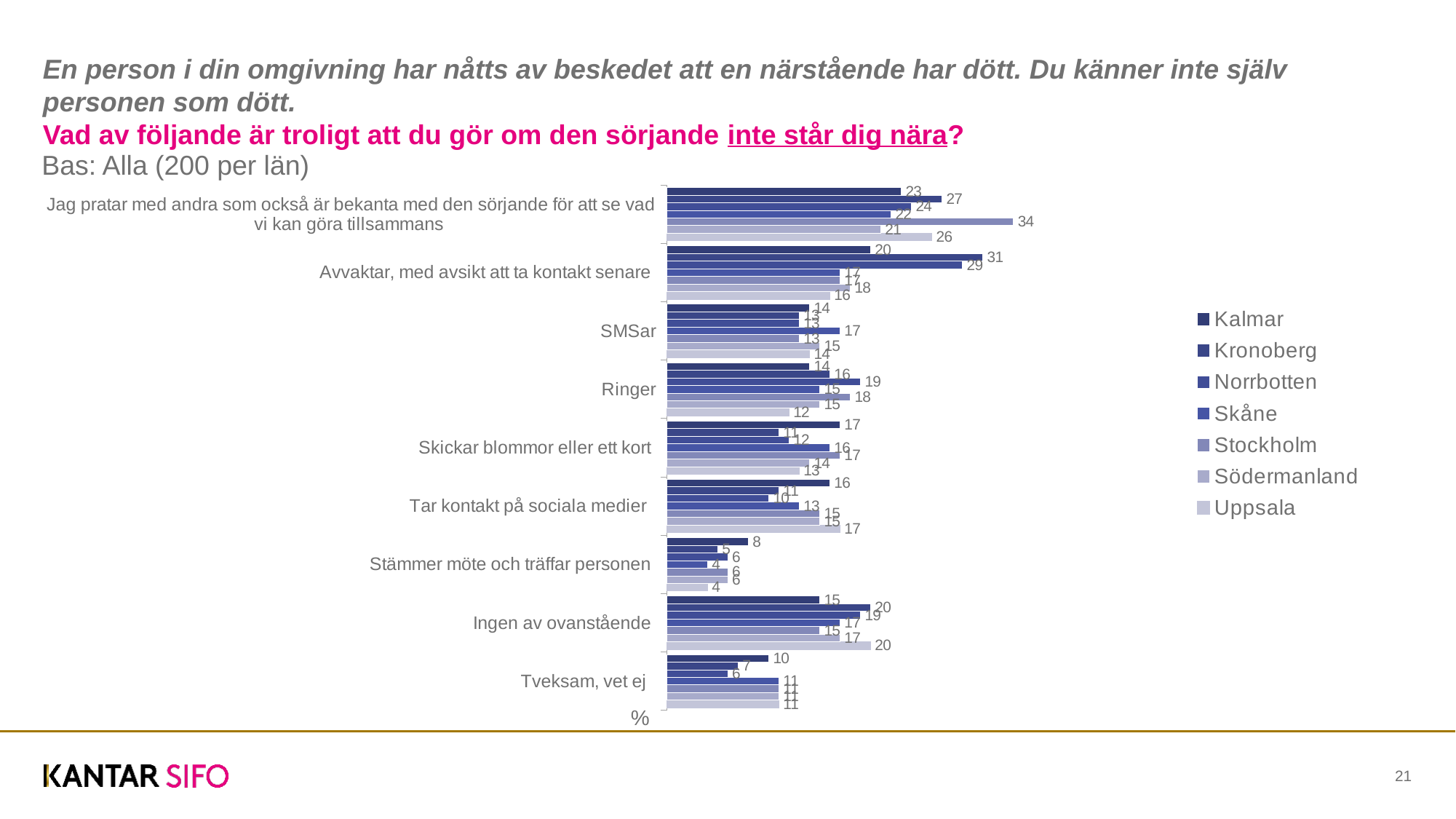
How many series does the legend list? 7 In the category "Avvaktar, med avsikt att ta kontakt senare", which is larger: Kalmar or Kronoberg? Kronoberg What is the value for Uppsala in the category "Ringer"? 12 Which county has the highest value in the category "Jag pratar med andra som också är bekanta med den sörjande för att se vad vi kan göra tillsammans"? Stockholm What is the value for Kalmar in the category "Tveksam, vet ej"? 10 What is the difference between Stockholm (34) and Södermanland (21) in the category "Jag pratar med andra som också är bekanta med den sörjande för att se vad vi kan göra tillsammans"? 13 What is the value for Kalmar in the category "Stämmer möte och träffar personen"? 8 What is the value for Stockholm in the category "Jag pratar med andra som också är bekanta med den sörjande för att se vad vi kan göra tillsammans"? 34 What kind of chart is shown on the slide? Bar chart How many categories are shown on the chart? 9 Which county is listed first in the legend? Kalmar What is the value for Kronoberg in the category "Avvaktar, med avsikt att ta kontakt senare"? 31